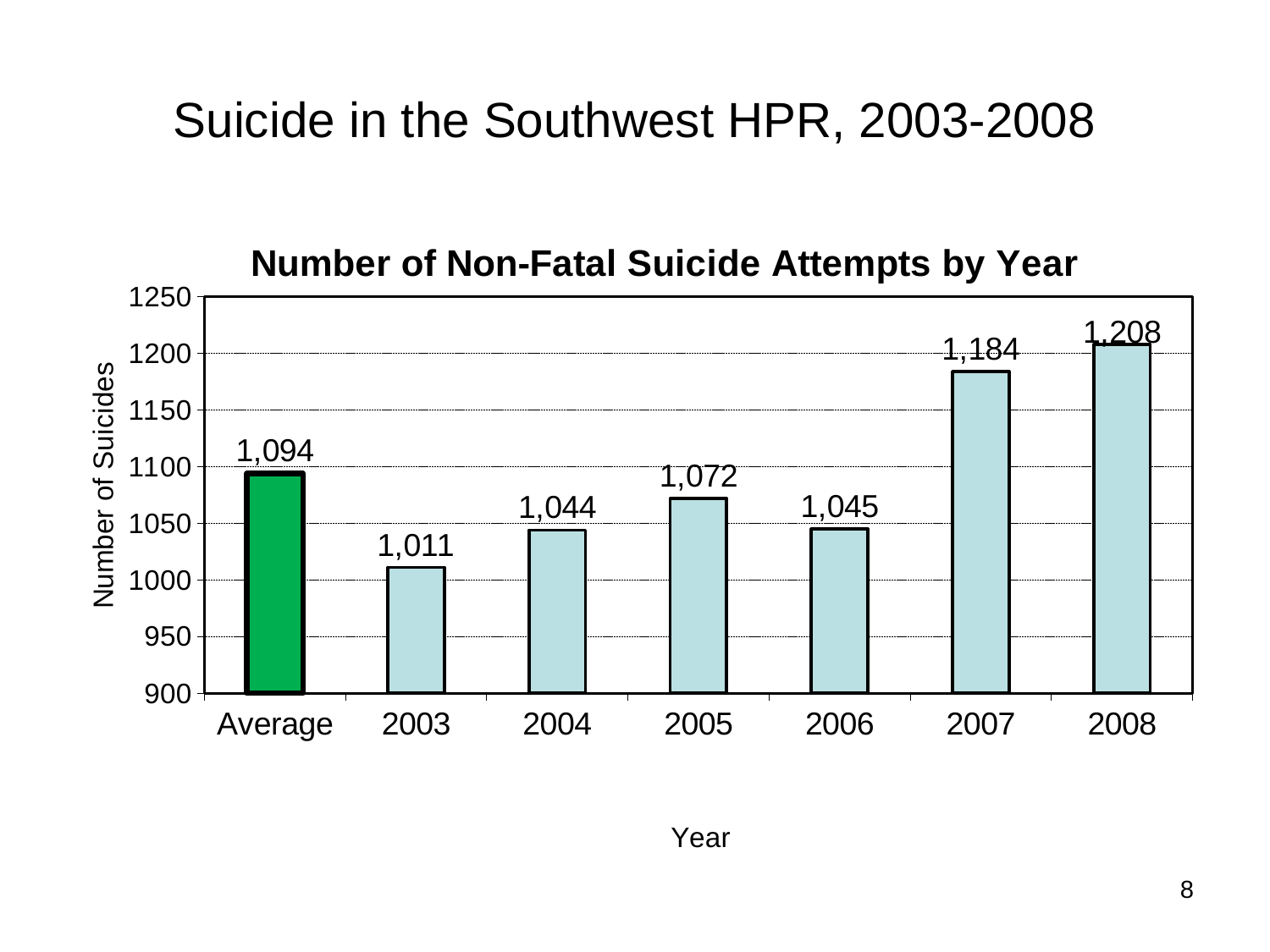
What kind of chart is shown on the slide? bar chart Which year has the highest number of non-fatal suicide attempts? 2008 What is the difference between the values for 2007 and 2006? 139 What is the value for 2007? 1,184 What is the value for the Average bar? 1,094 Which is larger, the value for 2005 or the value for 2006? 2005 How many bars are shown in the chart? 7 What is the value for 2003? 1,011 Which year has the lowest number of non-fatal suicide attempts? 2003 What is the difference between the values for 2008 and 2003? 197 Is the value for 2008 greater or less than 1200? greater What is the title of the chart? Number of Non-Fatal Suicide Attempts by Year